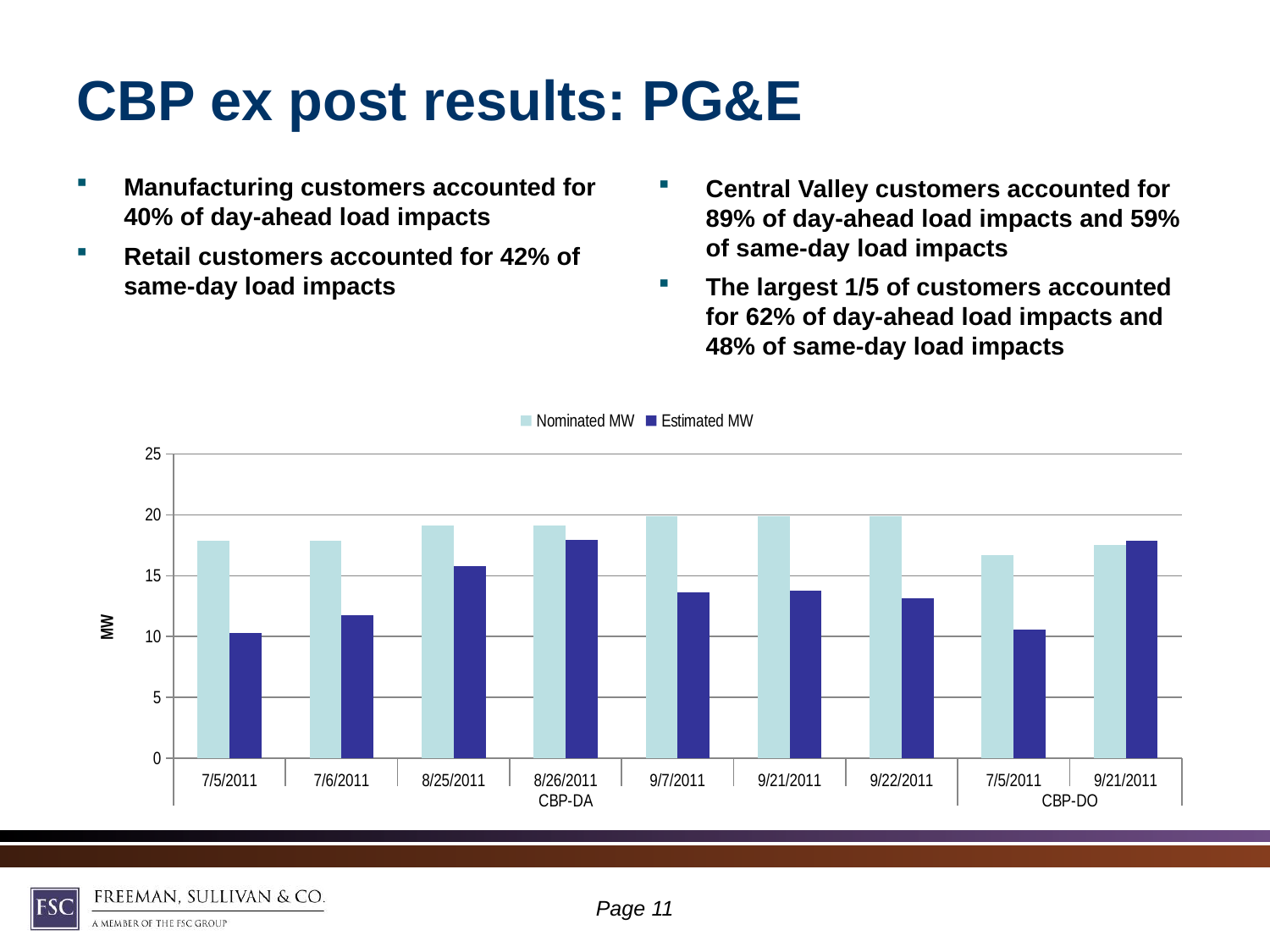
What label is shown on the y axis of the chart? MW Is the Estimated MW value for 8/26/2011 greater or less than 15? greater Is the Estimated MW value for 9/22/2011 greater or less than 15? less Is the Estimated MW value for 7/6/2011 greater or less than 10? greater Which is larger: the Estimated MW for 8/25/2011 or the Estimated MW for 7/6/2011? 8/25/2011 For 7/5/2011 under CBP-DA, which is larger: Nominated MW or Estimated MW? Nominated MW What are the two program groups labelled beneath the x axis of the chart? CBP-DA and CBP-DO What kind of chart is shown on the slide? Bar chart How many date categories are plotted along the x axis of the chart? 9 How many series does the chart legend list? 2